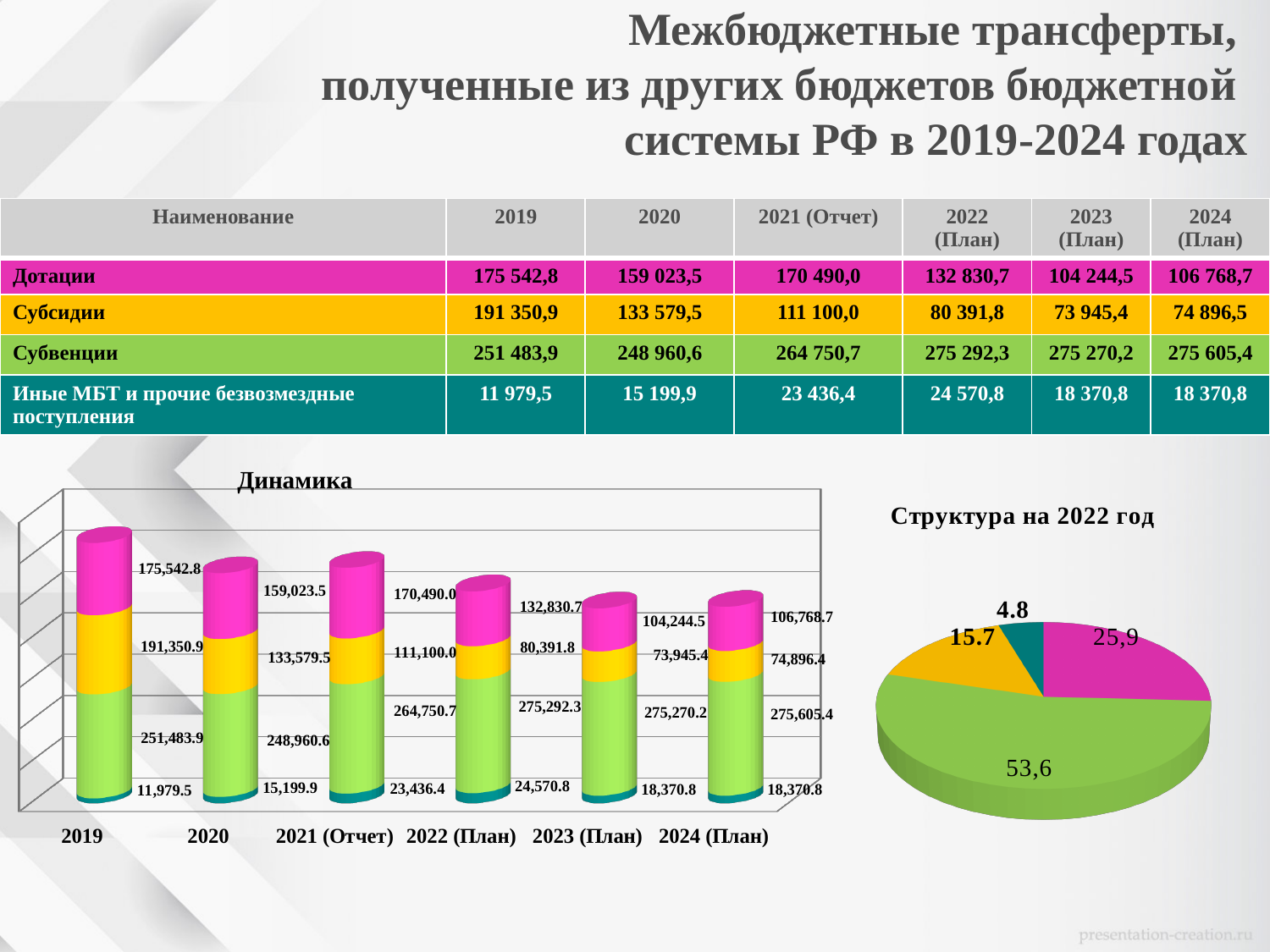
In the "Структура на 2022 год" pie chart, what share does the largest (green) slice have? 53,6 In the "Динамика" chart, does the yellow segment value rise or fall from 2019 to 2023 (План)? fall In the "Динамика" chart, what is the total of the stacked bar for 2019? 630,357.1 In the "Динамика" chart, how many segments does each stacked bar have? 4 What type of chart is the "Структура на 2022 год" chart? pie chart In the "Динамика" chart, what is the difference between the green segment values for 2024 (План) and 2019? 24,121.5 In the "Динамика" chart, which year has the largest pink (top) segment value? 2019 In the "Динамика" chart, what is the value of the green segment for 2022 (План)? 275,292.3 What type of chart is the "Динамика" chart? bar chart In the "Динамика" chart, what is the value of the pink (top) segment for 2019? 175,542.8 In the "Динамика" chart, which is larger: the yellow segment for 2019 or the yellow segment for 2024 (План)? 2019 In the "Динамика" chart, how many years are shown on the x axis? 6